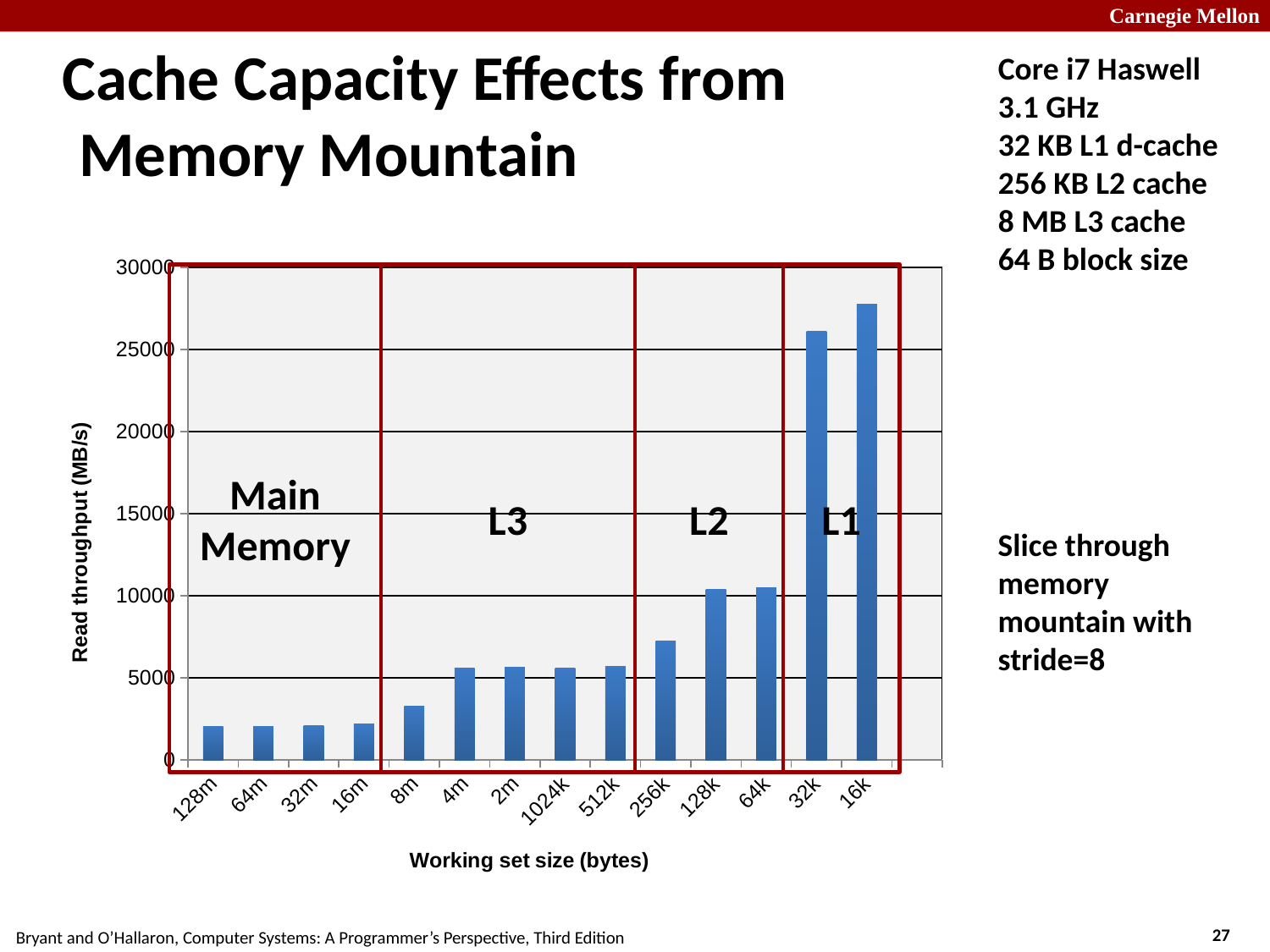
Which cache region label is placed over the bars for 256k, 128k and 64k? L2 Is the read throughput for a working set size of 8m greater or less than 5000? less How many working set sizes are plotted along the x axis? 14 Do the read throughput values generally rise or fall moving from left to right along the x axis? rise What is the label of the y axis? Read throughput (MB/s) Which working set size has the highest read throughput? 16k What kind of chart is shown on the slide? bar chart Is the read throughput for a working set size of 128k greater or less than 5000? greater Is the read throughput for a working set size of 16k greater or less than 25000? greater Which has the higher read throughput: a working set size of 256k or 8m? 256k